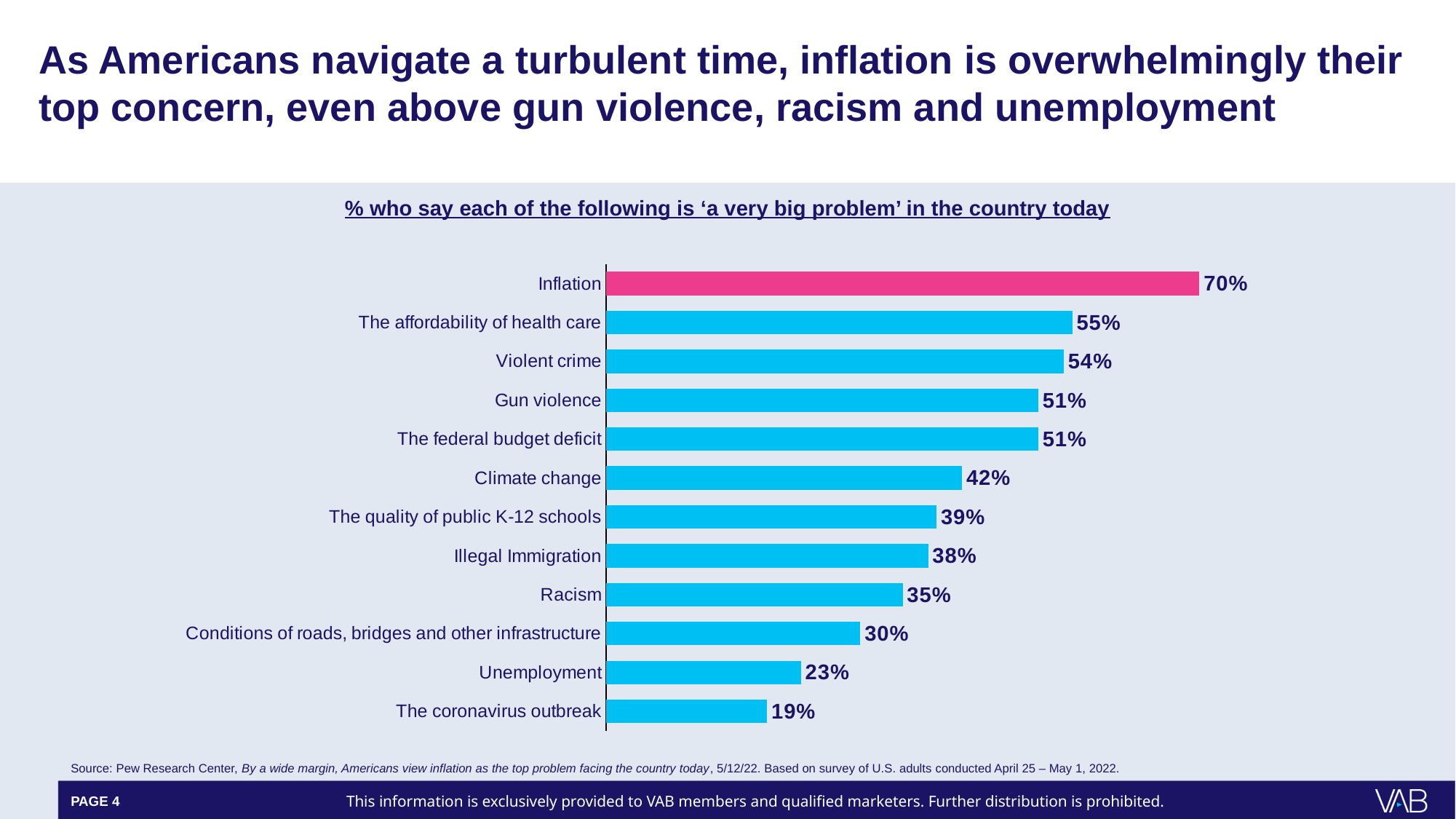
What is the difference between the values for Inflation and Unemployment? 47% Which is larger, the value for Illegal Immigration or the value for Conditions of roads, bridges and other infrastructure? Illegal Immigration Which two categories share the value 51%? Gun violence and The federal budget deficit How many categories are shown in the chart? 12 What is the value for Climate change? 42% What percentage say inflation is a very big problem? 70% Which bar is coloured differently from the others? Inflation What is the difference between the values for The affordability of health care and Racism? 20% What kind of chart is shown on the slide? Bar chart Which category has the highest value? Inflation Which category has the lowest value? The coronavirus outbreak What is the value for The coronavirus outbreak? 19%